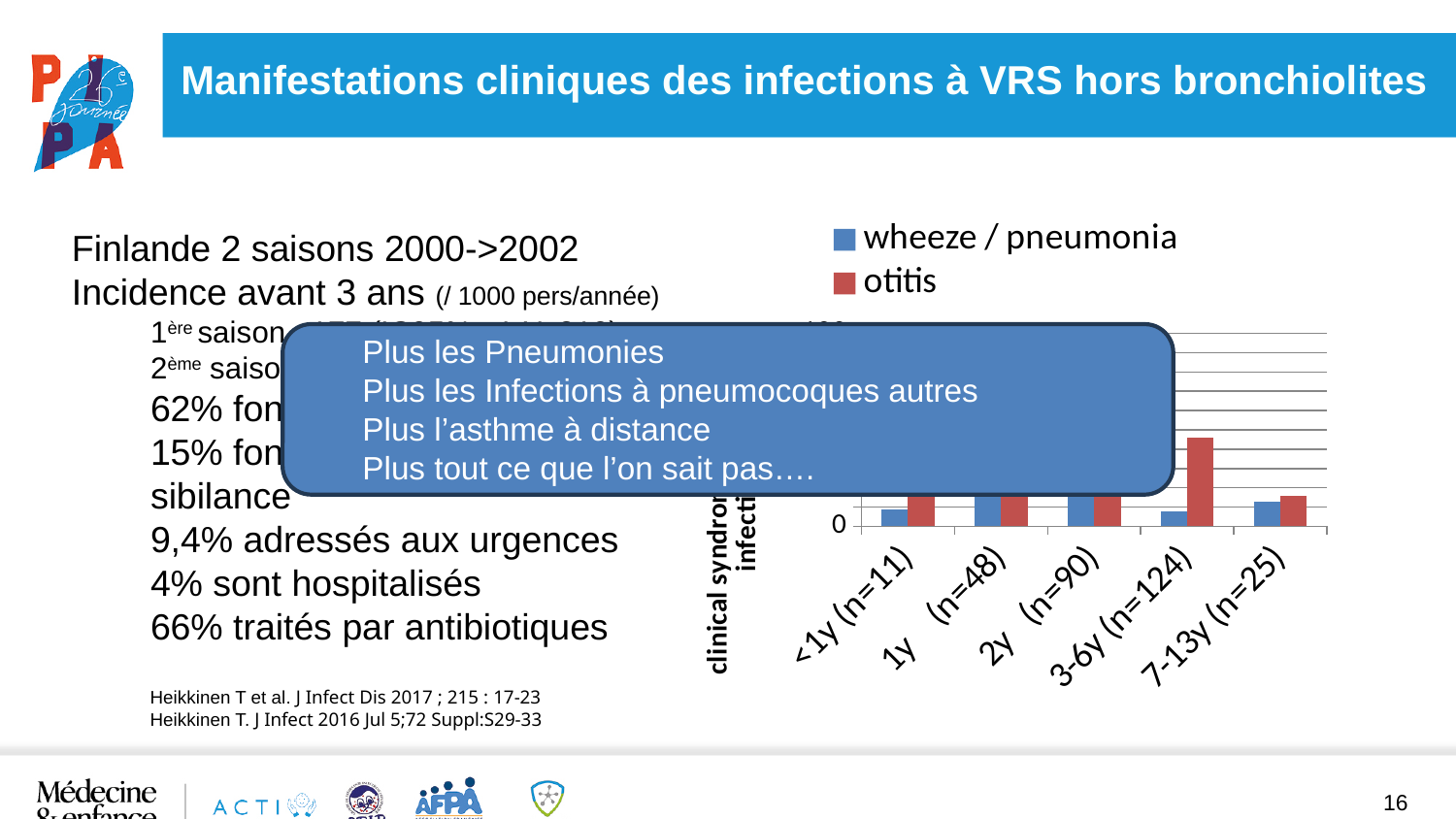
Which series is shown in red in the chart? otitis Which series is shown in blue in the chart? wheeze / pneumonia What is the label of the last category on the x axis of the chart? 7-13y (n=25) For the otitis series, which is larger: the value for 3-6y (n=124) or the value for 7-13y (n=25)? 3-6y (n=124) How many series does the chart's legend list? 2 How many age categories are shown on the x axis of the chart? 5 What kind of chart is shown on the slide? bar chart In the 3-6y (n=124) category, which is larger: the otitis bar or the wheeze / pneumonia bar? otitis